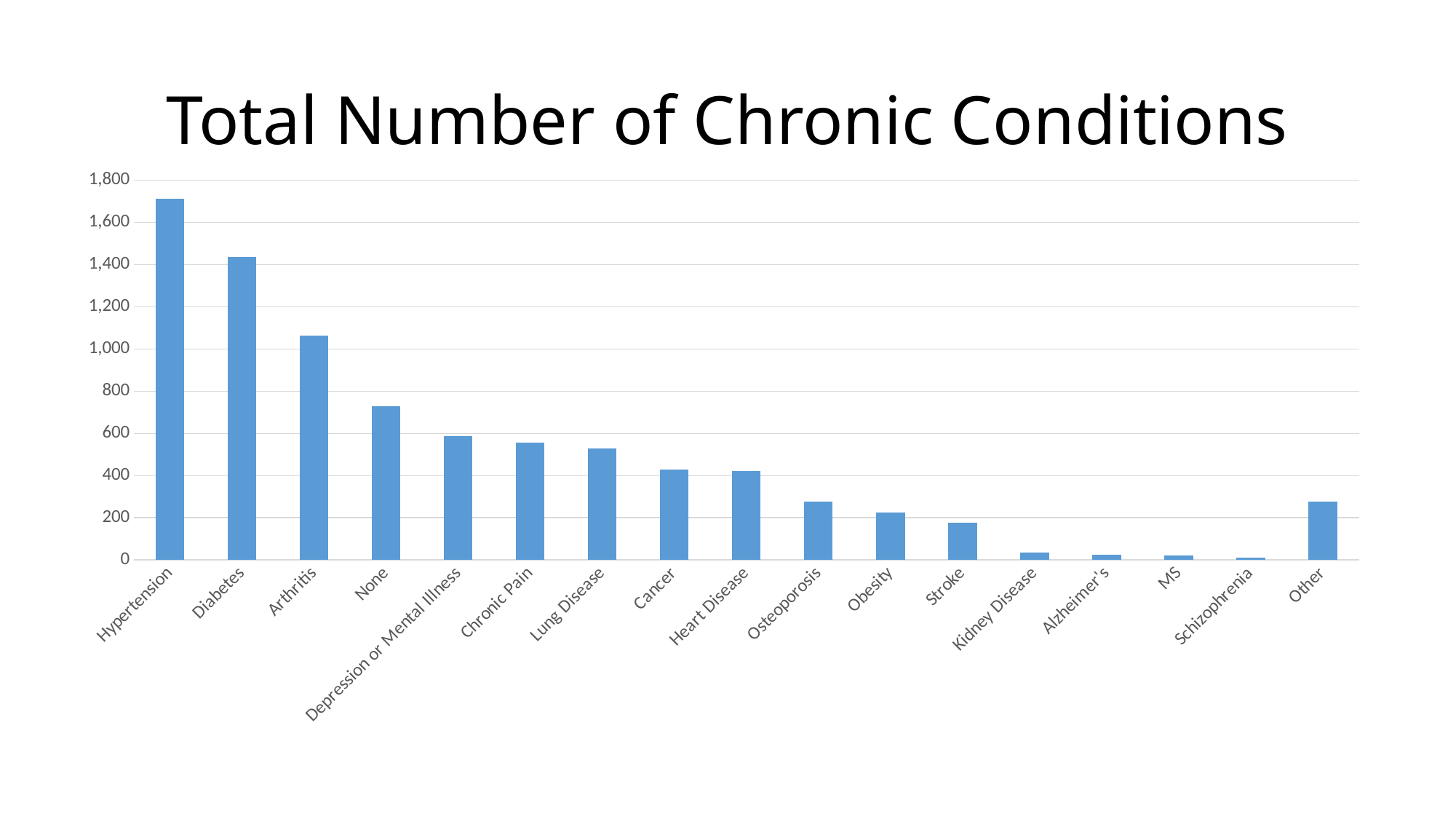
Is the value for Stroke greater or less than 200? less Is the value for Arthritis greater or less than 1,000? greater Which is larger, the value for Arthritis or the value for None? Arthritis Is the value for Hypertension greater or less than 1,600? greater What kind of chart is shown on the slide? bar chart Do the values generally rise or fall along the x axis from Hypertension to Schizophrenia? fall Which category has the lowest bar in the chart? Schizophrenia Which chronic condition has the highest total number? Hypertension What is the title of the chart? Total Number of Chronic Conditions How many categories are shown on the x axis of the chart? 17